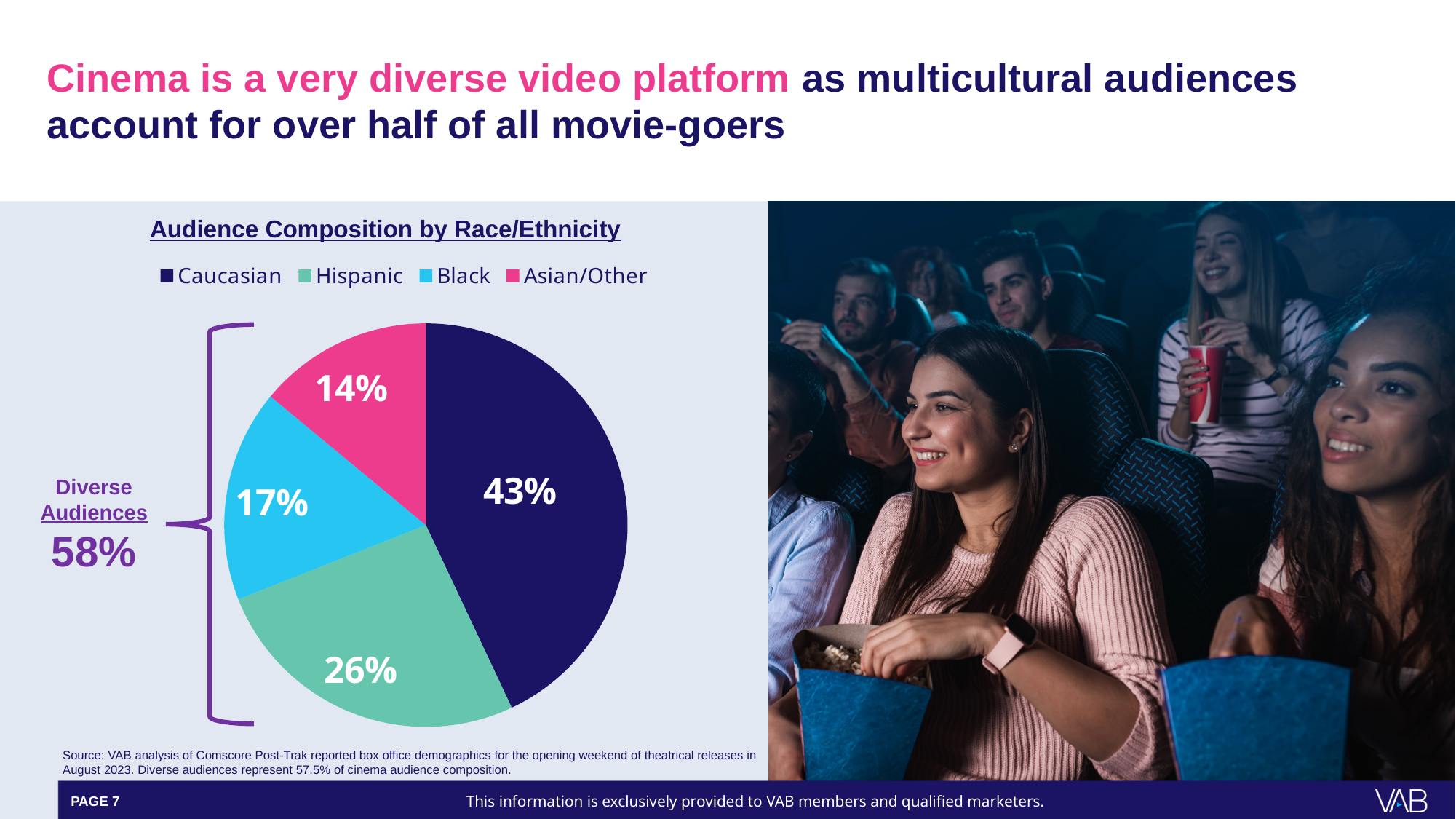
Which is larger, the Black share or the Asian/Other share? Black What share of the audience is Caucasian? 43% What combined share is labelled as Diverse Audiences next to the pie chart? 58% How many race/ethnicity categories are shown in the pie chart? 4 What share of the audience is Hispanic? 26% What share of the audience is Asian/Other? 14% What is the title of the chart? Audience Composition by Race/Ethnicity What share of the audience is Black? 17% Which race/ethnicity group has the smallest slice of the pie? Asian/Other What is the difference in percentage points between the Caucasian and Hispanic shares? 17 What type of chart is used to show audience composition by race/ethnicity? Pie chart Which race/ethnicity group has the largest slice of the pie? Caucasian